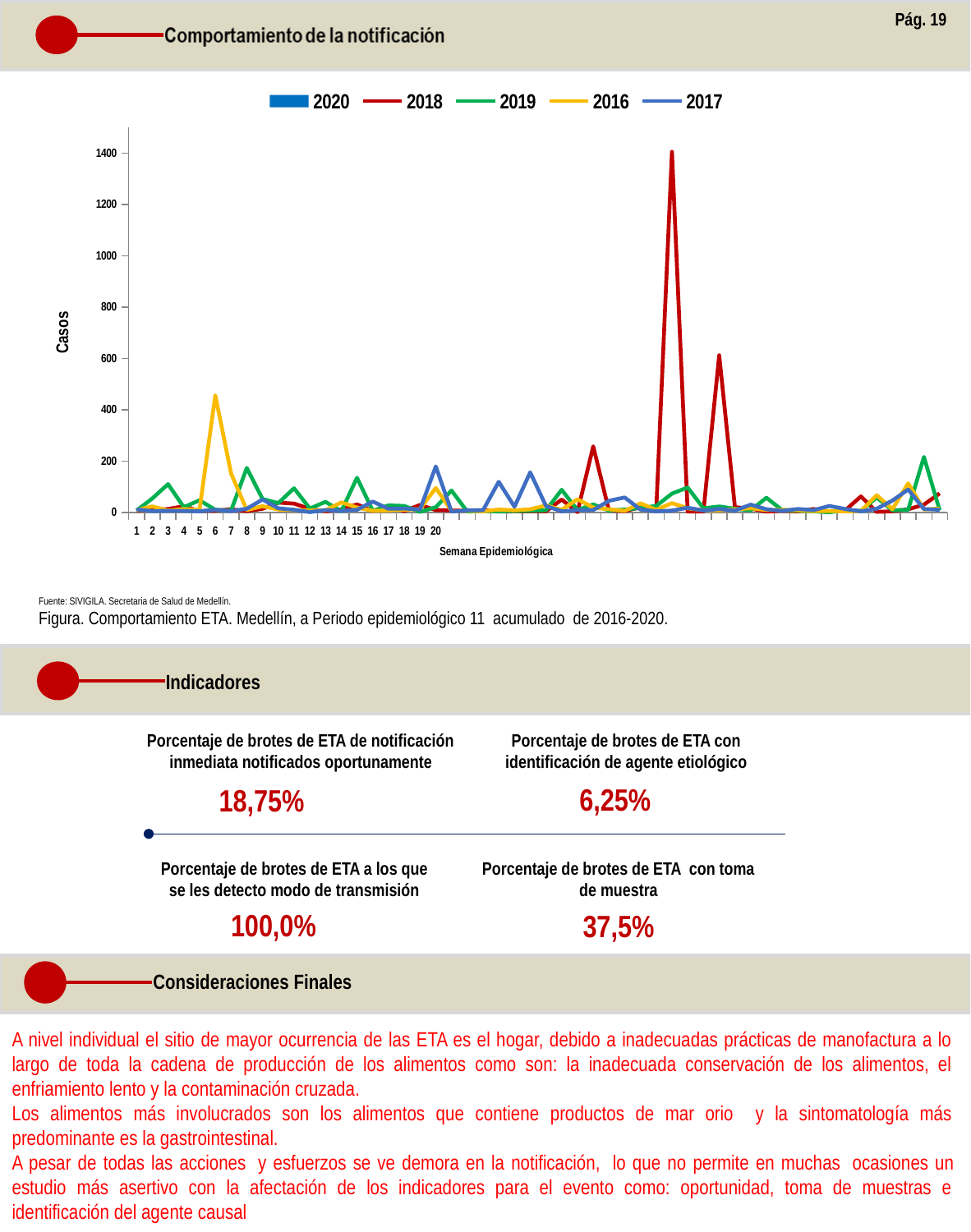
What is the highest tick value shown on the vertical axis? 1400 What kind of chart is shown on the slide? line chart Which series reaches the highest value on the chart? 2018 Is the peak of the 2016 series at week 6 greater or less than 600? less Which years are listed in the chart legend? 2020, 2018, 2019, 2016, 2017 Is the peak of the 2016 series at week 6 greater or less than 400? greater Which series has the highest value around week 6? 2016 Is the highest peak of the 2018 series greater or less than 1200? greater How many series does the chart legend list? 5 What is the title of the vertical axis of the chart? Casos Which is larger: the highest peak of the 2018 series or the highest peak of the 2016 series? 2018